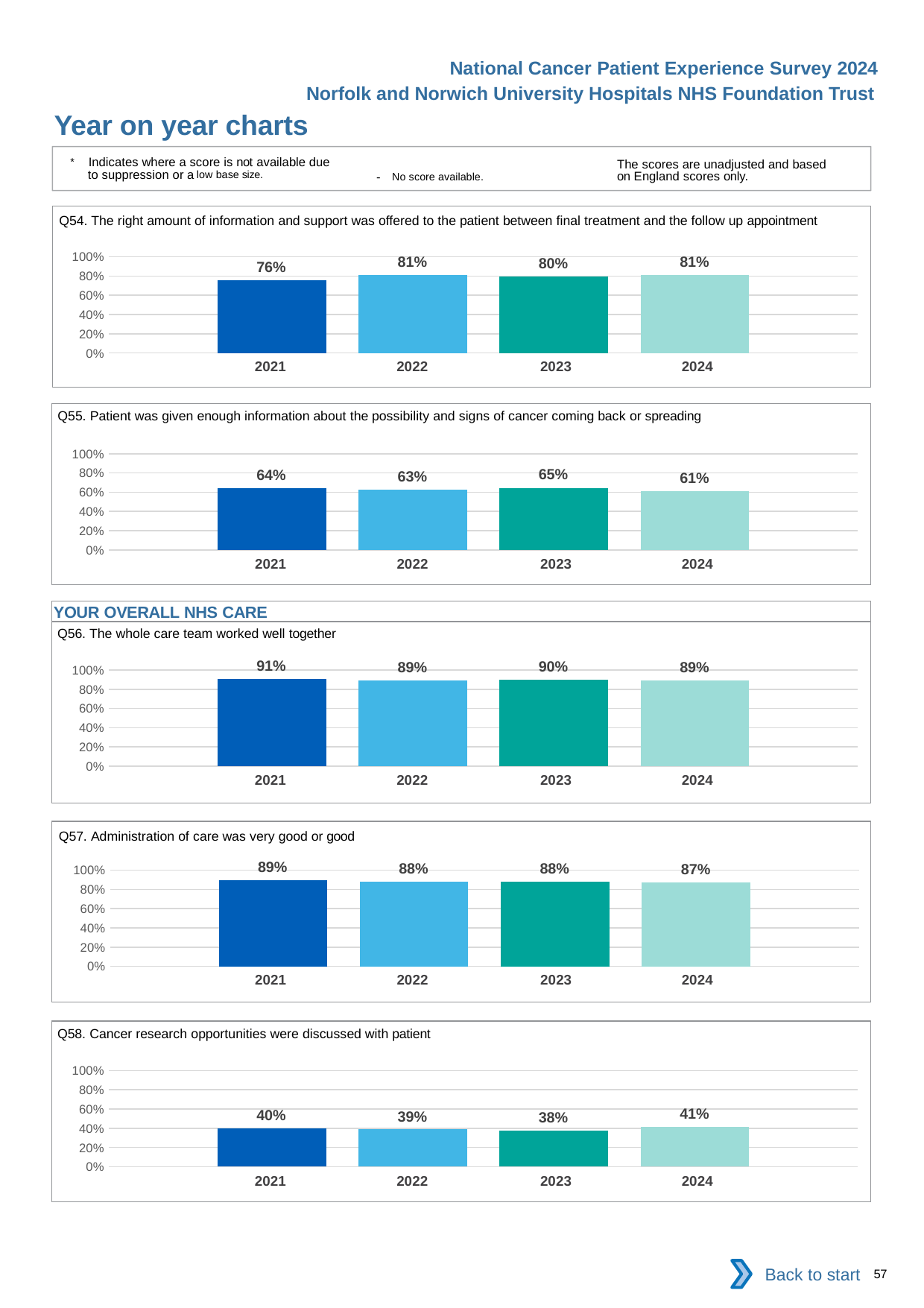
In the Q56 chart, what is the value for 2023? 90% In the Q54 chart, what is the difference between the 2022 value and the 2021 value? 5% What kind of chart is the Q56 chart? bar chart How many years are shown in the Q54 chart? 4 In the Q57 chart, what is the difference between the 2021 value and the 2024 value? 2% In the Q56 chart, what is the value for 2021? 91% In the Q58 chart, is the value for 2023 greater or less than 60%? less In the Q58 chart, which year has the highest value? 2024 In the Q55 chart, which is larger, the value for 2021 or the value for 2022? 2021 In the Q55 chart, which year has the lowest value? 2024 In the Q54 chart, what is the value for 2021? 76% What is the section heading shown above the Q56 chart? YOUR OVERALL NHS CARE